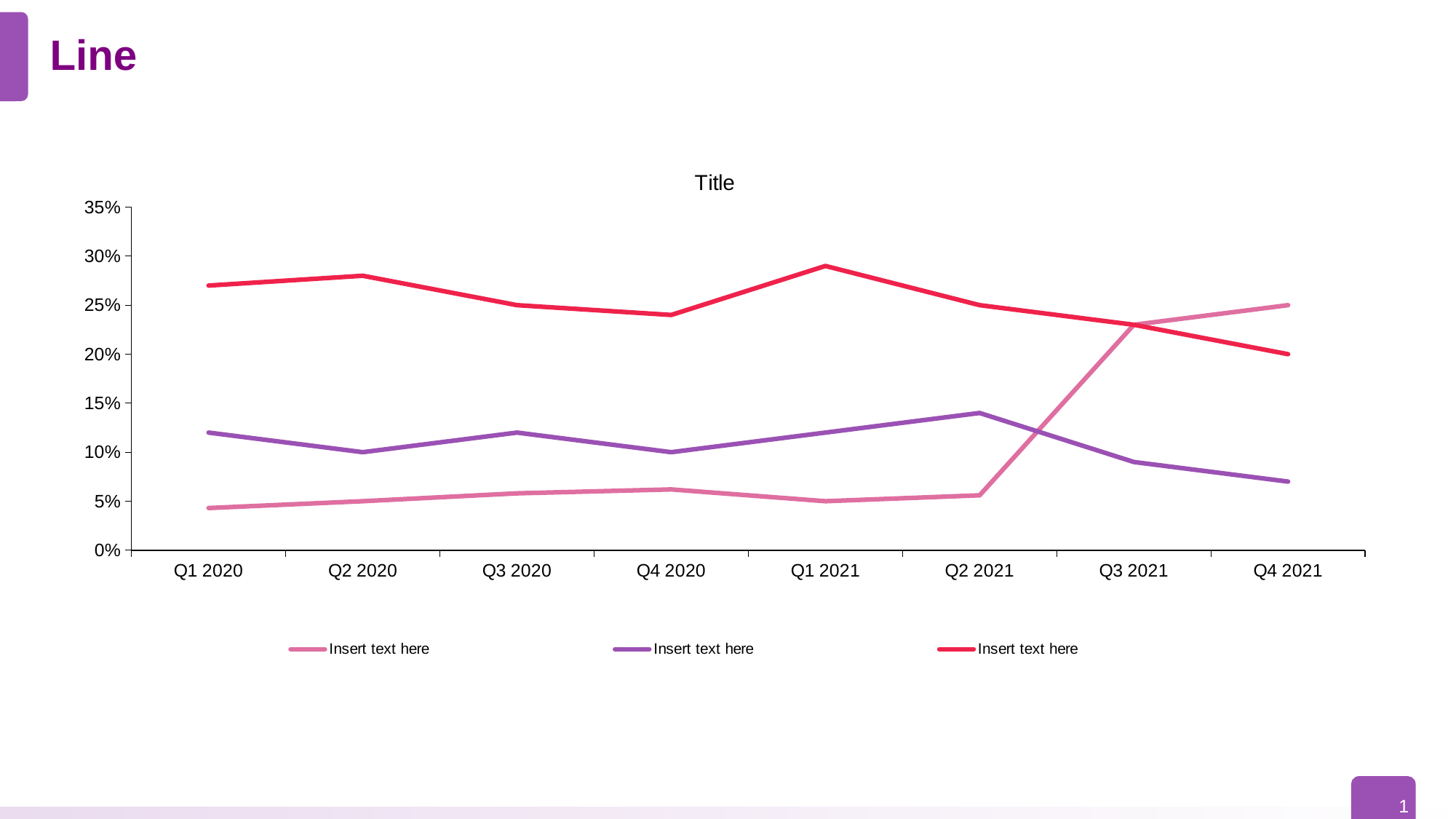
At Q3 2021, which line is higher: the pink line or the purple line? pink line In which quarter does the red line reach its highest value? Q1 2021 Is the value of the red line at Q1 2021 greater or less than 25%? greater Is the value of the pink line at Q1 2020 greater or less than 5%? less How many series does the legend list? 3 What is the value of the purple line at Q2 2020? 10% Does the red line rise or fall from Q1 2021 to Q4 2021? fall How many quarters are shown along the x axis? 8 What is the value of the red line at Q4 2021? 20% What is the value of the pink line at Q4 2021? 25% In which quarter does the purple line reach its lowest value? Q4 2021 What kind of chart is shown on the slide? line chart